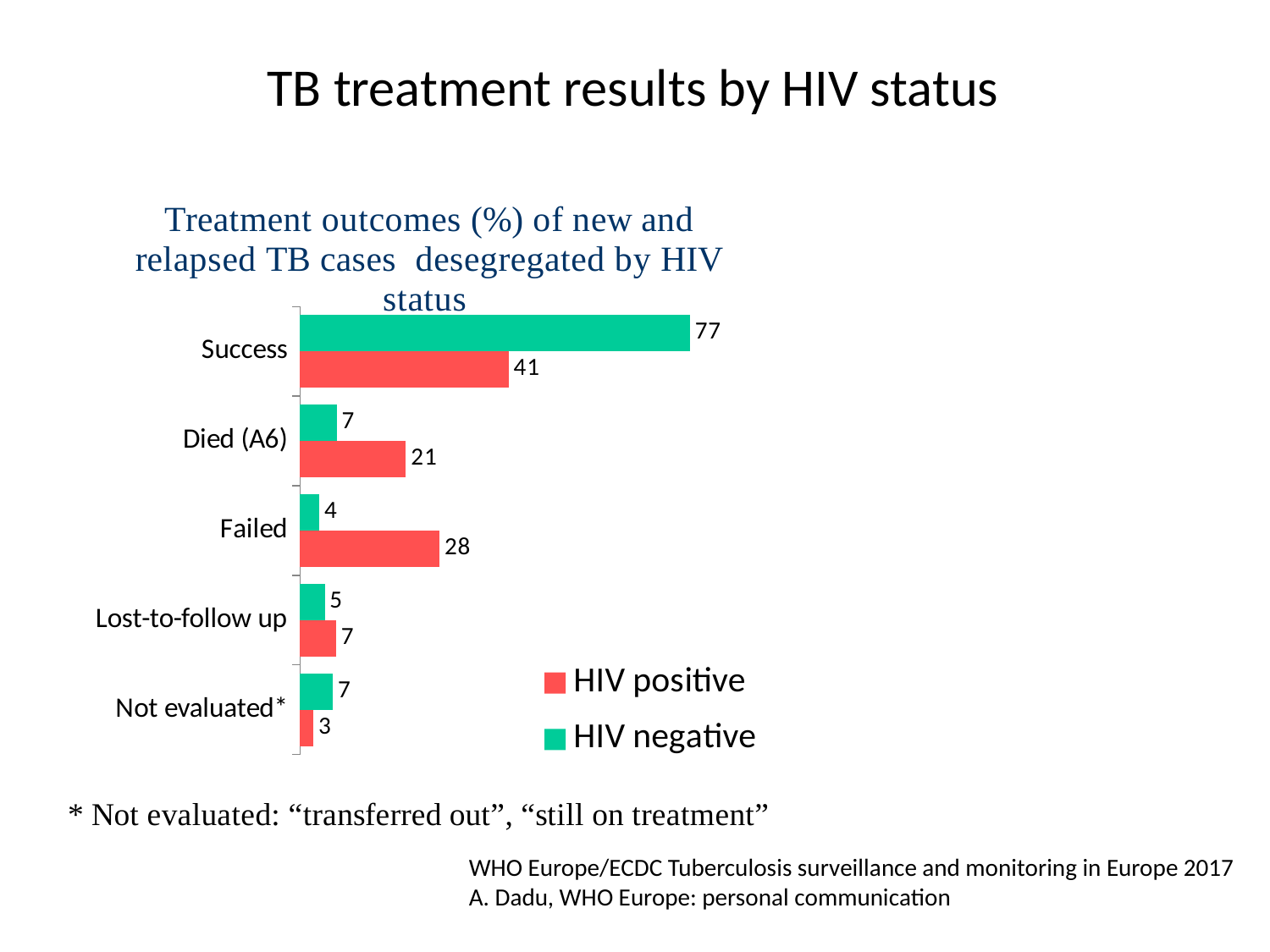
What is the HIV negative value for Success? 77 Which category has the highest HIV positive value? Success How many series does the legend list? 2 What kind of chart is shown on the slide? Bar chart What is the HIV negative value for Lost-to-follow up? 5 Which colour represents the HIV negative series? Green Which category has the lowest HIV positive value? Not evaluated* How many categories are shown on the chart? 5 What is the HIV positive value for Died (A6)? 21 For Failed, which is larger: the HIV positive value or the HIV negative value? HIV positive What is the difference between the HIV negative and HIV positive values for Success? 36 What is the HIV positive value for Failed? 28